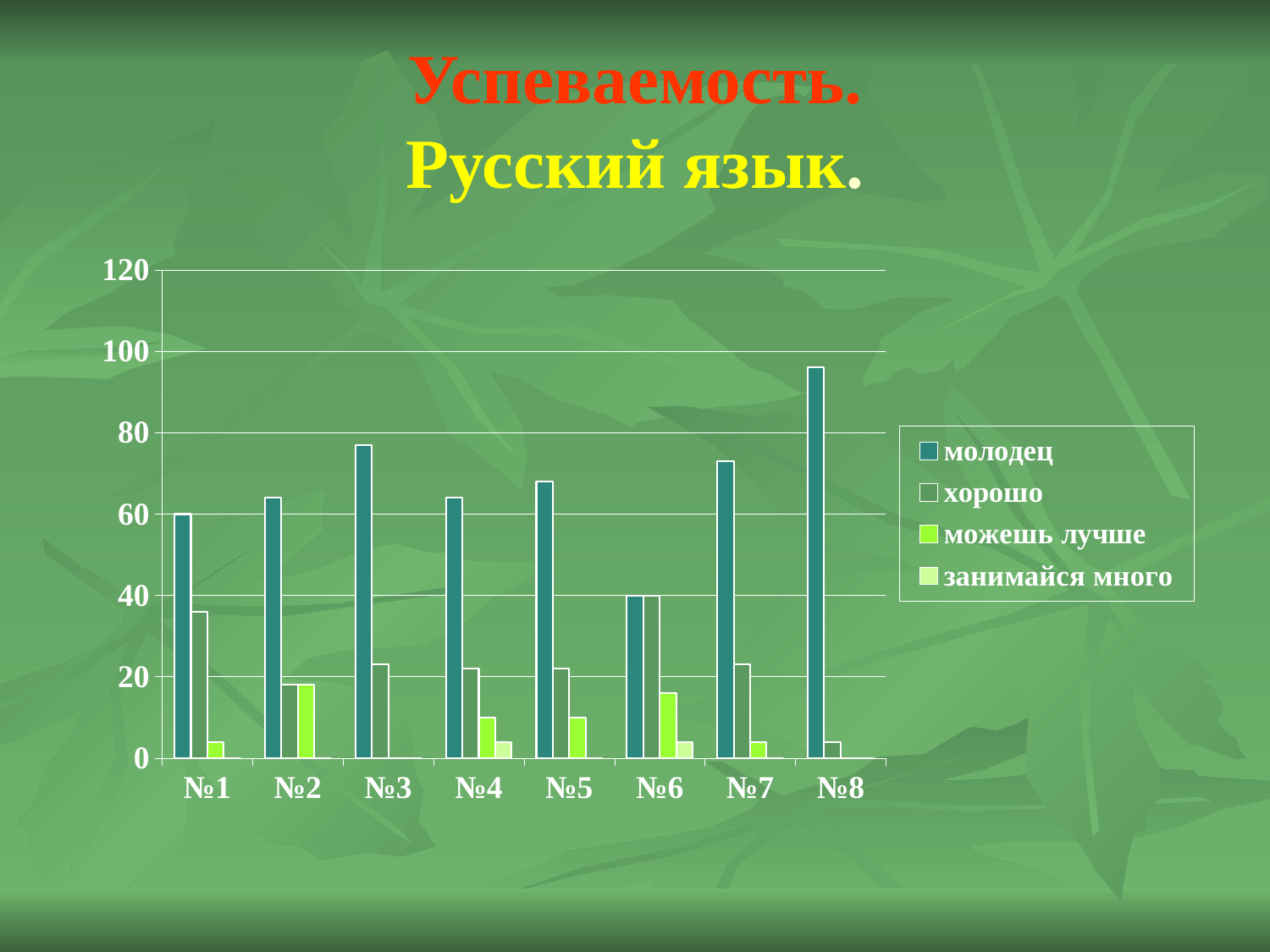
How many series does the chart legend list? 4 Is the value for "хорошо" in category №1 greater or less than 20? greater Is the value for "молодец" in category №8 greater or less than 80? greater Is the value for "молодец" in category №3 greater or less than 60? greater What is the title of the slide containing the chart? Успеваемость. Русский язык. Which is larger: the value for "молодец" in category №8 or in category №3? №8 Which category has the highest value for the series "молодец"? №8 Which category has the highest value for the series "хорошо"? №6 How many categories are shown on the x axis of the chart? 8 Which category has the lowest value for the series "молодец"? №6 What kind of chart is shown on the slide? bar chart